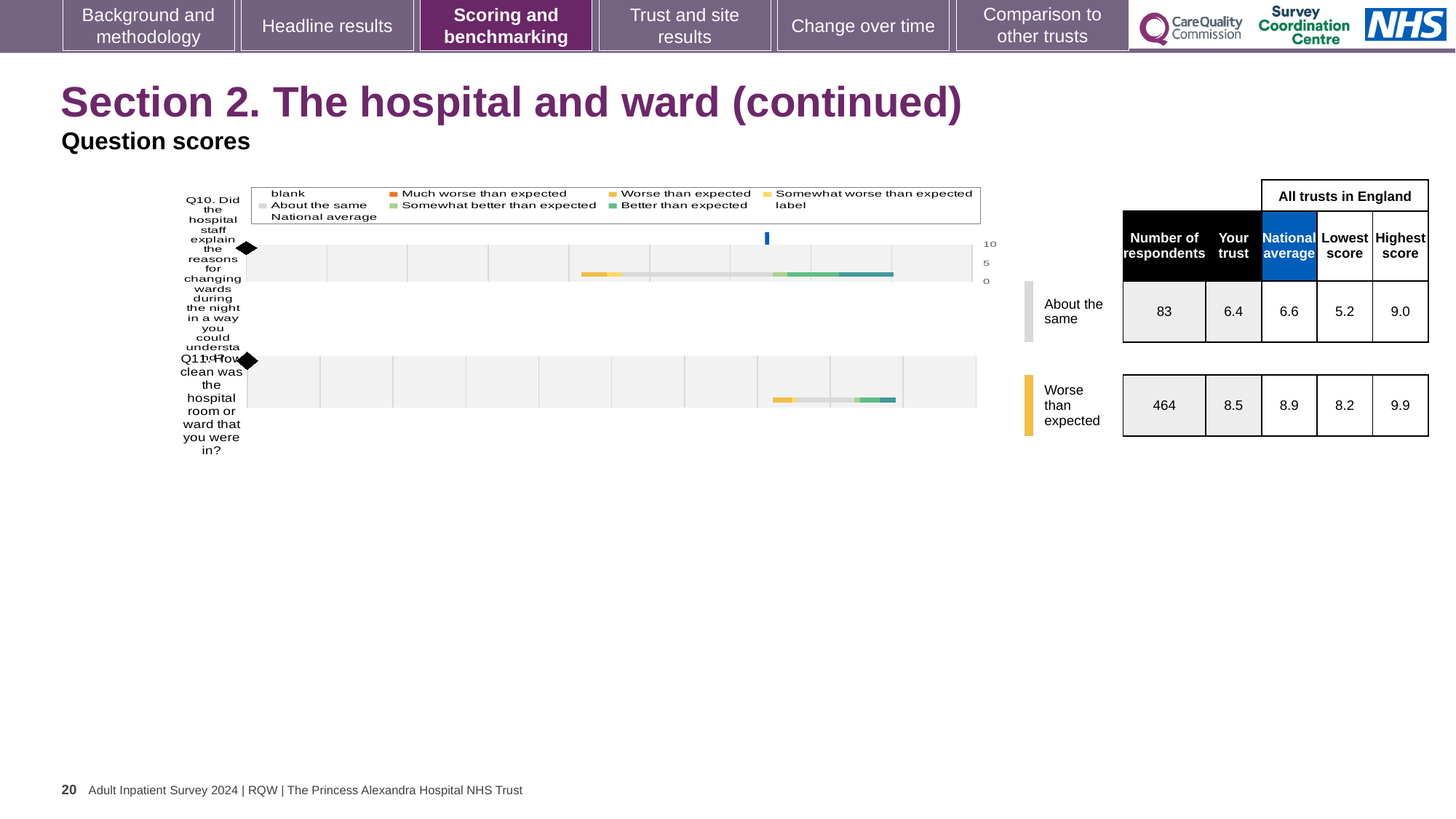
How many respondents answered Q11? 464 Is the 'Your trust' score for Q10 greater or less than 5 on the chart's axis? greater What kind of chart is used to show the question scores for Q10 and Q11? Bar chart What is the difference between the highest and lowest scores among all trusts in England for Q10? 3.8 Which benchmark category is the trust's Q11 score placed in? Worse than expected How many questions are plotted in the chart? 2 What is the highest score among all trusts in England for Q11? 9.9 Which benchmark category is the trust's Q10 score placed in? About the same What is the national average score for Q11 (how clean was the hospital room or ward)? 8.9 What is the 'Your trust' score for Q10 (explaining reasons for changing wards during the night)? 6.4 What is the difference between the national average and the 'Your trust' score for Q11? 0.4 Which question has the higher 'Your trust' score, Q10 or Q11? Q11